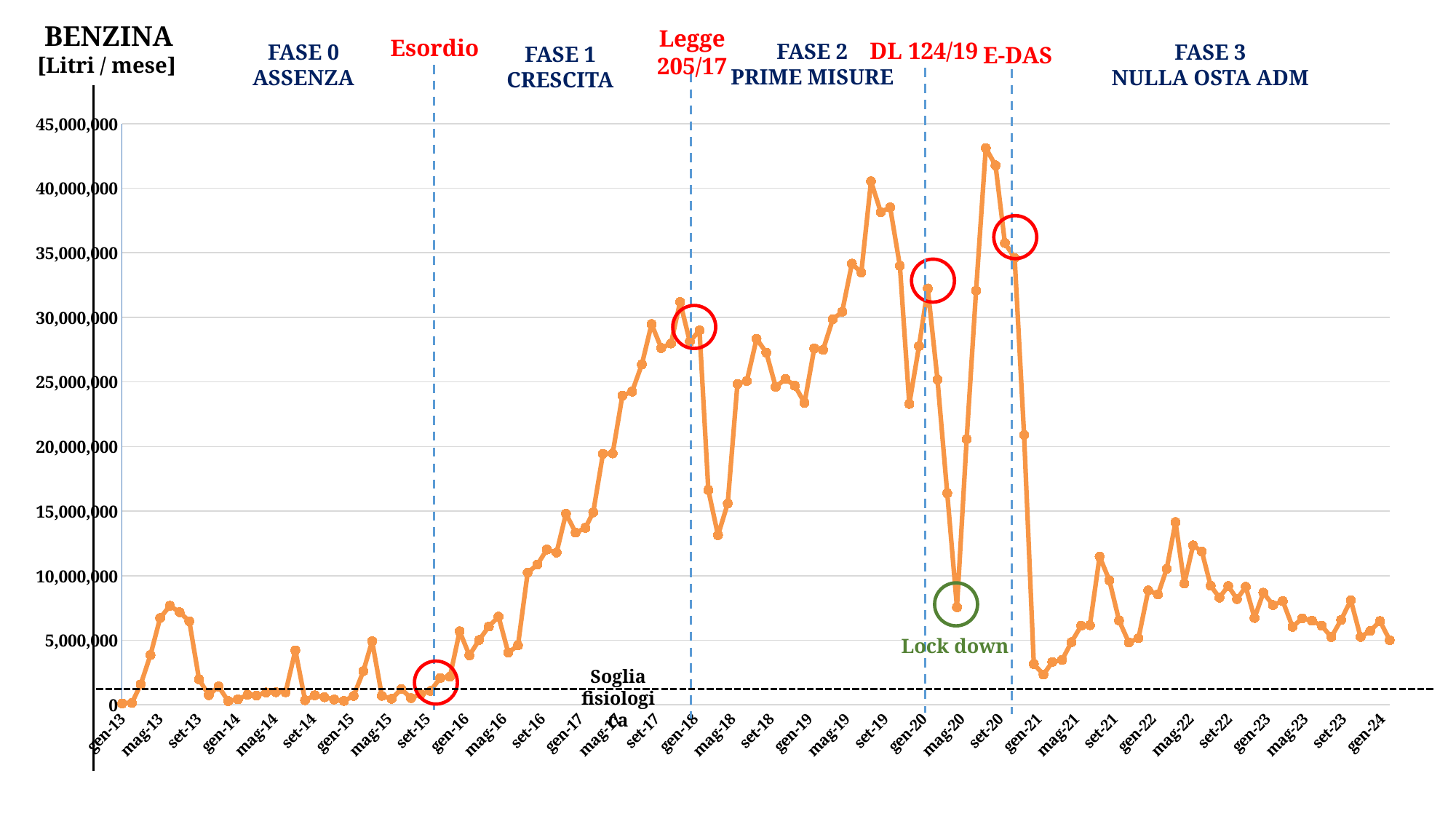
Is the value for mag-22 greater or less than 10,000,000? greater Do the values rise or fall along the x axis between gen-16 and set-17? rise Is the value for gen-13 greater or less than 5,000,000? less Is the value for set-20 greater or less than 40,000,000? less Do the values rise or fall along the x axis between set-20 and gen-21? fall What is the title of the chart? BENZINA What unit is given for the y axis of the chart? Litri / mese What kind of chart is shown on the slide? line chart